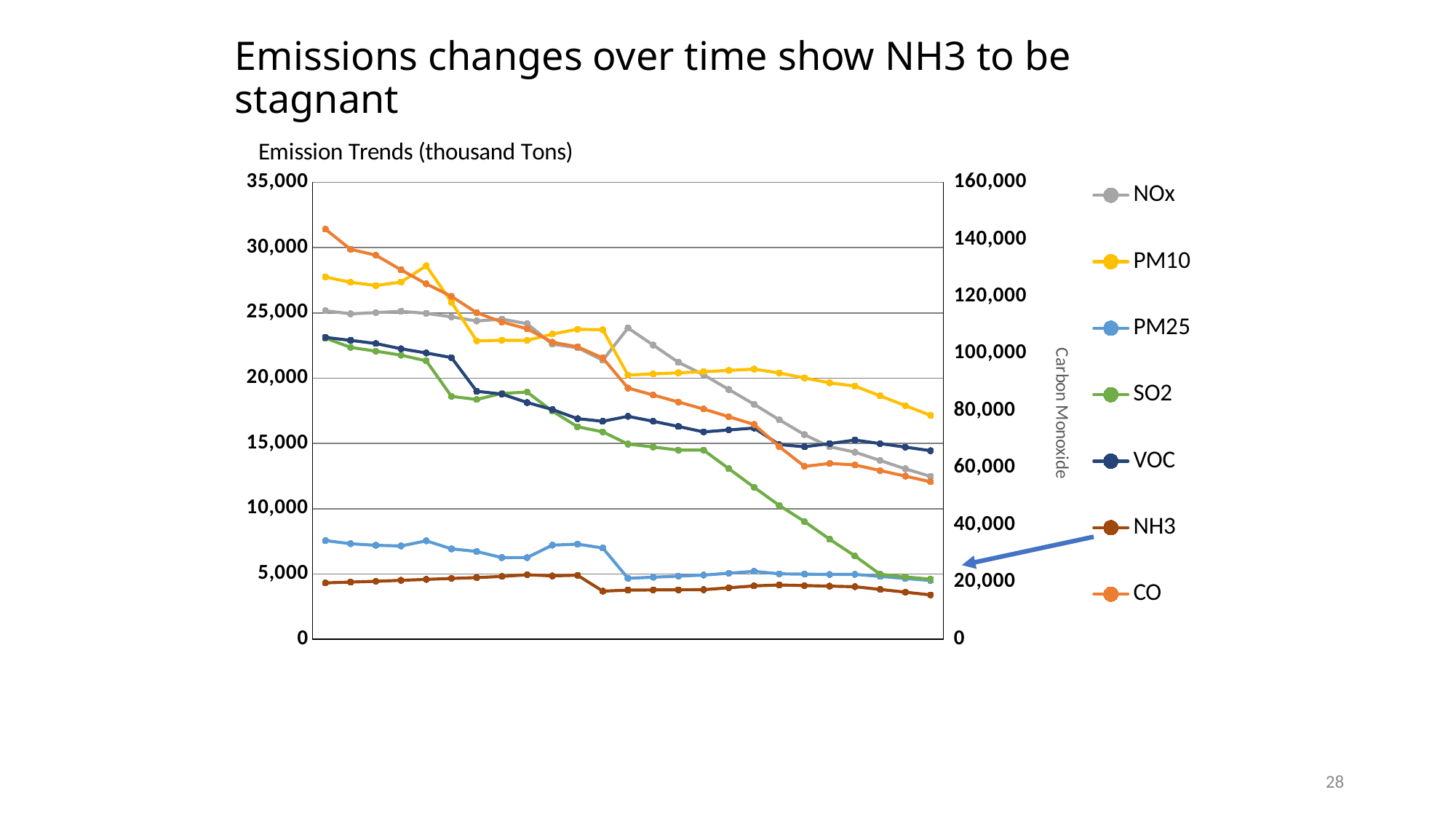
What kind of chart is shown on the slide? line chart Is the value for NOx at the end of the x axis greater or less than 15,000? less What is the title of the chart? Emission Trends (thousand Tons) Which series plotted on the left axis has the lowest value at the end of the x axis? NH3 How many series does the legend list? 7 What is the label of the secondary (right-hand) vertical axis? Carbon Monoxide Does the SO2 series rise or fall over the course of the x axis? fall Is the value for CO at the start of the x axis, read on the right-hand axis, greater or less than 120,000? greater Which series plotted on the left axis has the lowest value at the start of the x axis? NH3 Does the NOx series rise or fall overall from the start to the end of the x axis? fall Is the value for PM10 at the start of the x axis greater or less than 25,000? greater At the start of the x axis, which is larger: PM25 or NH3? PM25